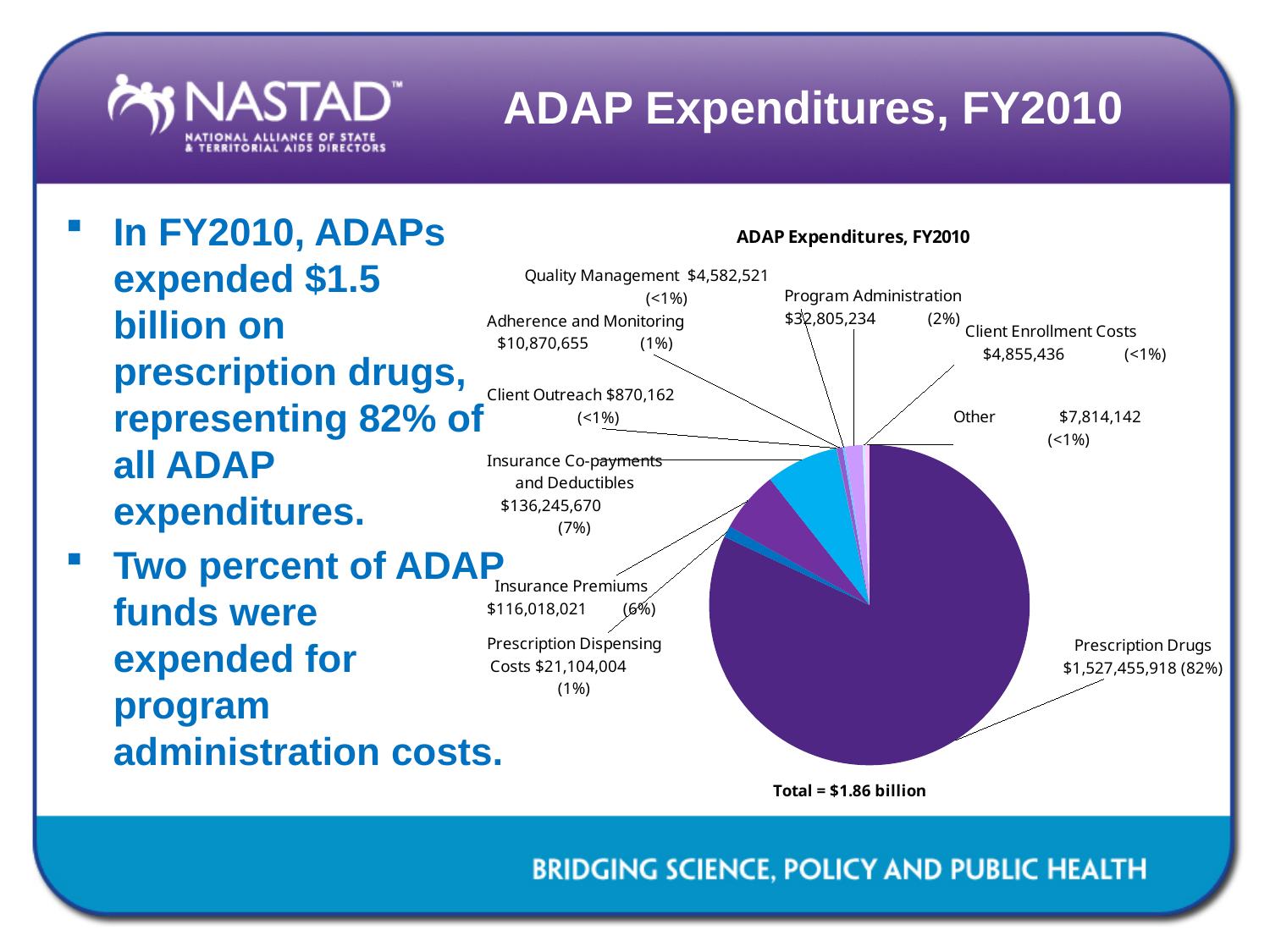
Which category has the largest expenditure? Prescription Drugs What kind of chart is shown on the slide? Pie chart What share of the pie does Insurance Premiums represent? 6% What is the expenditure value for Program Administration? $32,805,234 What is the expenditure value for Insurance Co-payments and Deductibles? $136,245,670 How many categories (slices) are labeled in the pie chart? 10 What is the expenditure value for Prescription Drugs? $1,527,455,918 Which category has the smallest expenditure? Client Outreach What share of the pie does Prescription Drugs represent? 82% What is the title of the chart? ADAP Expenditures, FY2010 Which is larger, the expenditure for Insurance Premiums or for Insurance Co-payments and Deductibles? Insurance Co-payments and Deductibles What is the total expenditure stated below the chart? $1.86 billion